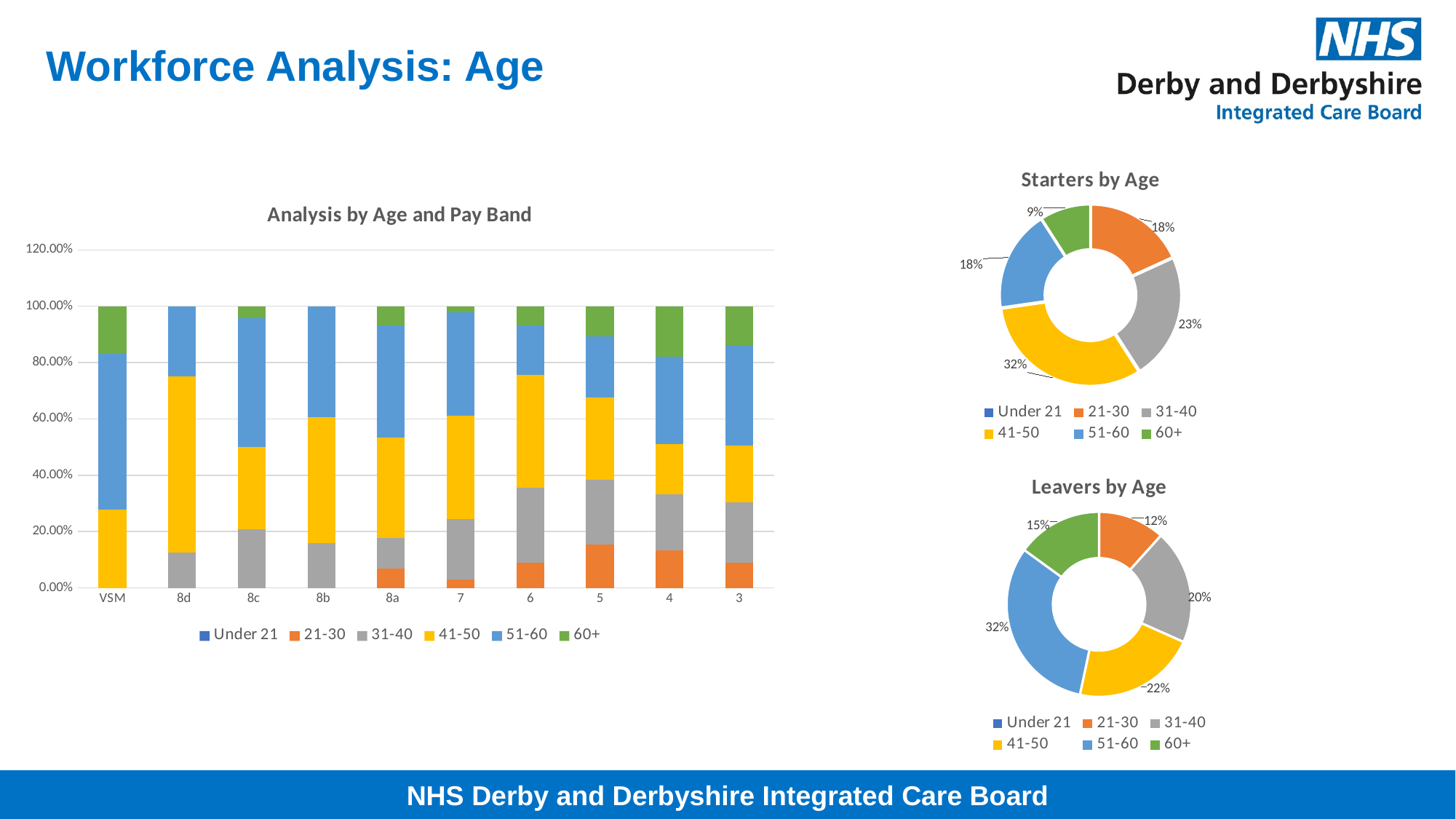
In the Analysis by Age and Pay Band chart, how many pay bands are shown on the x axis? 10 What kind of chart is the Analysis by Age and Pay Band chart? Stacked bar chart In the Starters by Age chart, which labelled age group has the smallest share? 60+ In the Leavers by Age chart, what share of leavers are aged 51-60? 32% In the Leavers by Age chart, what is the difference in percentage points between the 51-60 share and the 21-30 share? 20 percentage points In the Starters by Age chart, what share of starters are aged 41-50? 32% In the Leavers by Age chart, which labelled age group has the smallest share? 21-30 In the Analysis by Age and Pay Band chart, is the 41-50 share for VSM greater or less than 20%? greater Is the 31-40 share larger in the Starters by Age chart or the Leavers by Age chart? Starters by Age In the Leavers by Age chart, which age group has the largest share? 51-60 In the Analysis by Age and Pay Band chart, how many age groups does the legend list? 6 In the Starters by Age chart, which age group has the largest share? 41-50